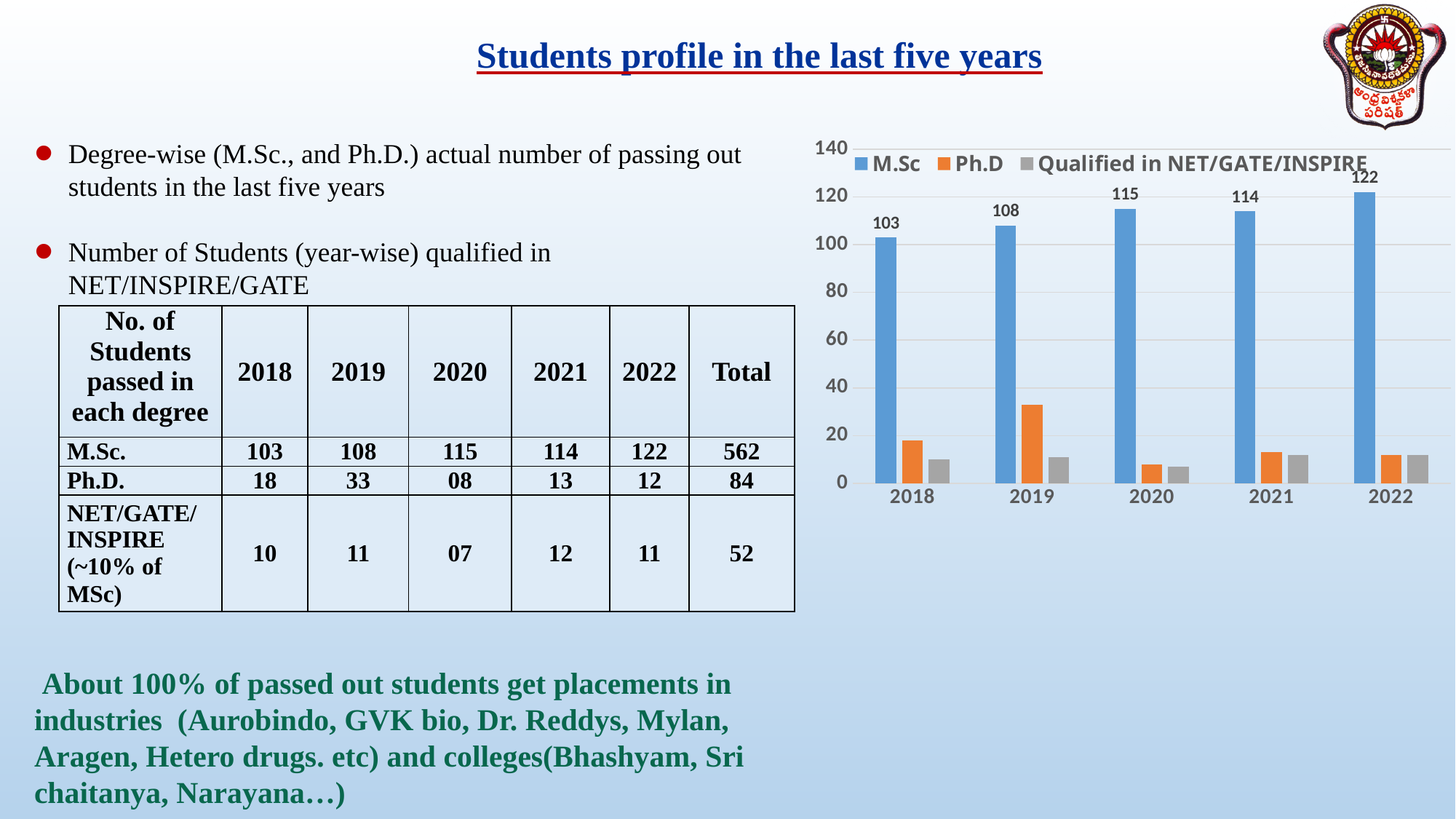
In which year is the M.Sc value lowest? 2018 How many years are shown on the x axis of the chart? 5 What is the value for M.Sc in 2018? 103 Which year has the larger M.Sc value, 2019 or 2021? 2021 How many series does the chart legend list? 3 What kind of chart is shown on the slide? bar chart Is the value for Ph.D in 2020 greater or less than 20? less What is the value for M.Sc in 2022? 122 What is the value for M.Sc in 2020? 115 What is the difference between the M.Sc values for 2022 and 2018? 19 In which year is the M.Sc value highest? 2022 Is the value for Ph.D in 2019 greater or less than 20? greater